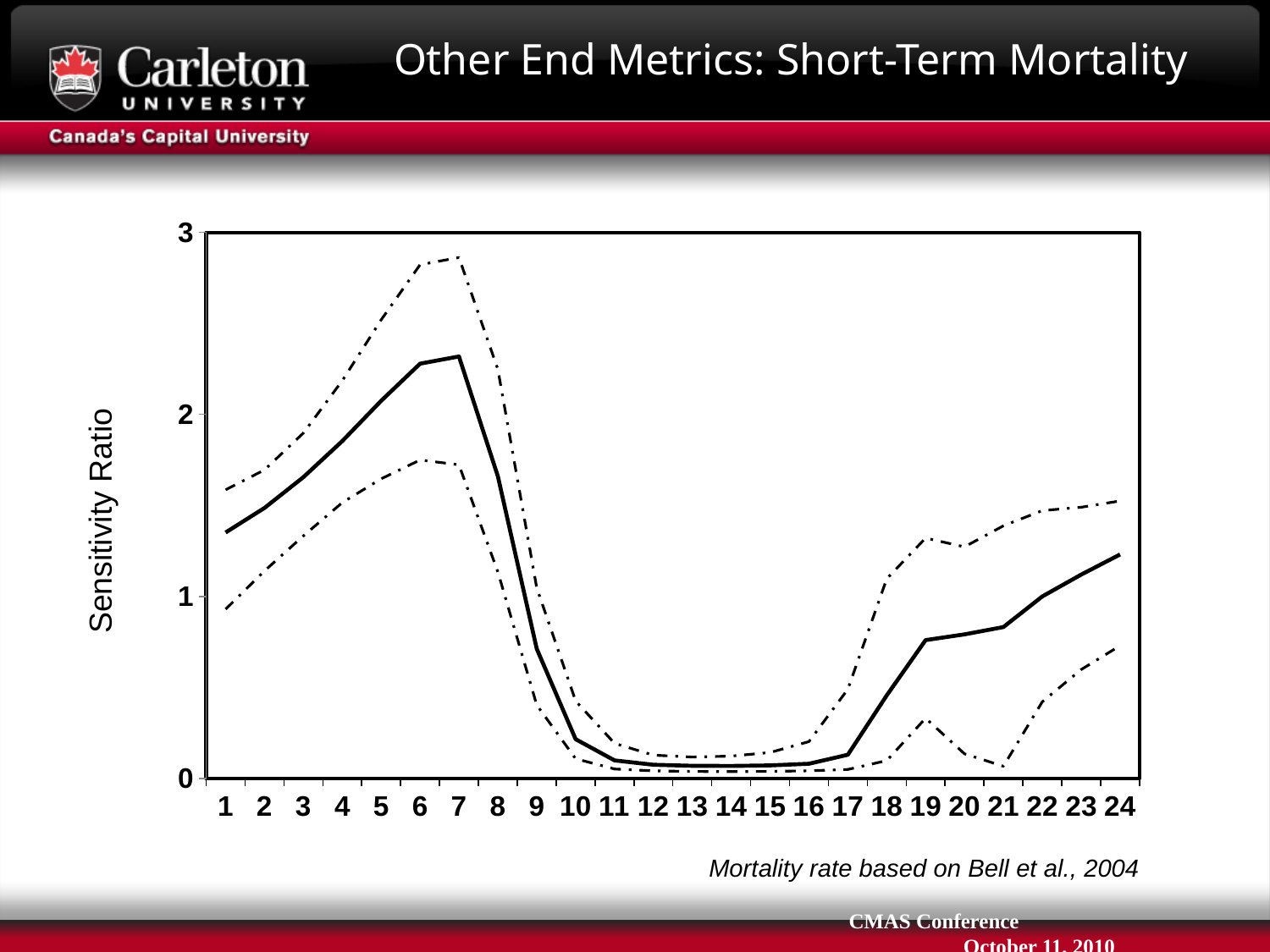
How many points are labelled along the x axis of the chart? 24 How many lines are plotted on the chart? 3 Is the value of the solid line at x = 1 greater or less than 1? greater Does the solid line rise or fall between x = 17 and x = 24? rise Is the value of the solid line at x = 13 greater or less than 1? less What is the label of the y axis of the chart? Sensitivity Ratio Is the value of the solid line at x = 24 greater or less than 1? greater What kind of chart is shown on the slide? line chart Does the solid line rise or fall between x = 7 and x = 10? fall Which has the larger value on the solid line, x = 7 or x = 24? x = 7